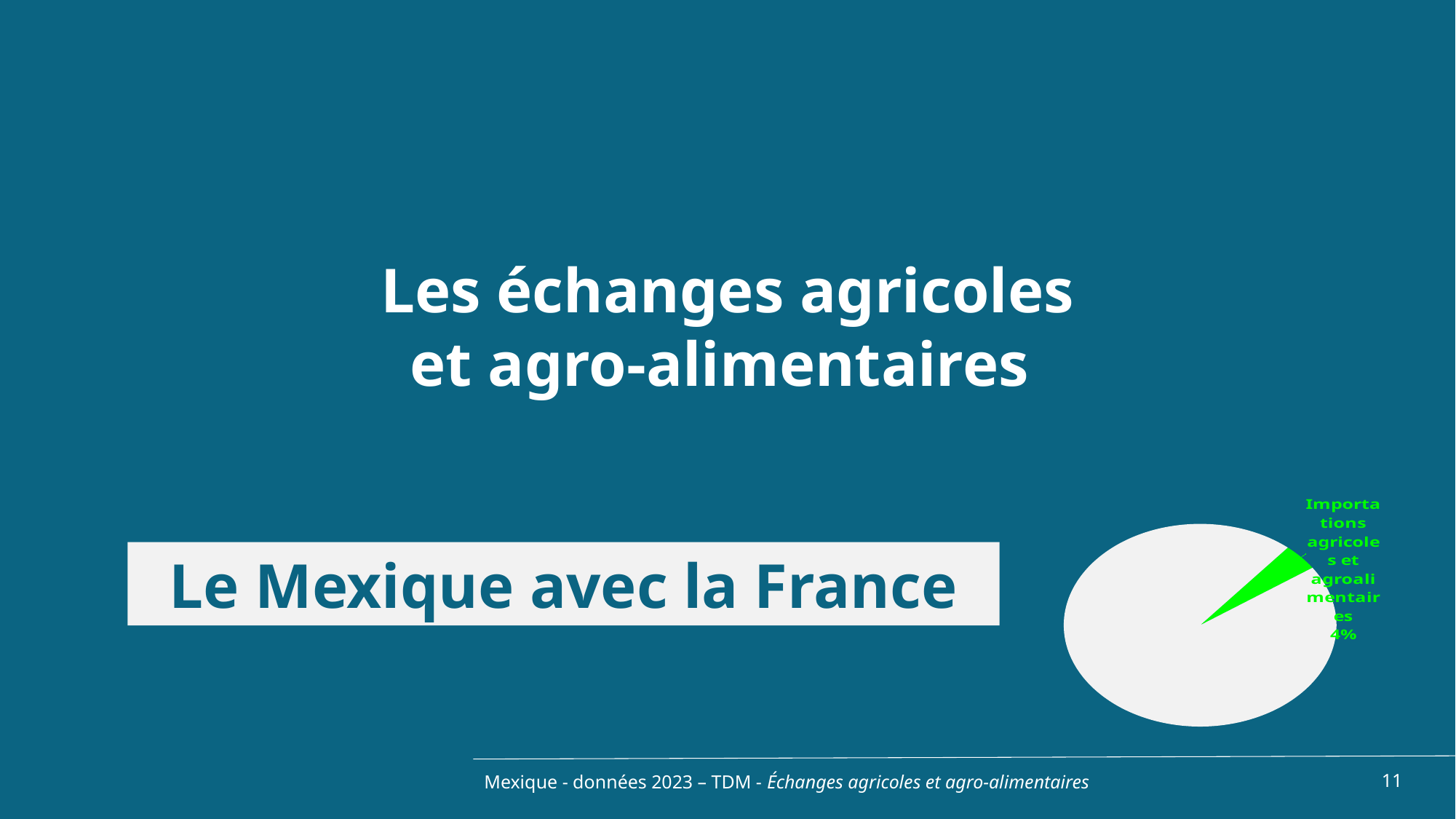
What colour is the slice labelled "Importations agricoles et agroalimentaires"? green How many slices does the pie chart show? 2 What is the percentage printed on the green slice of the pie chart? 4% Is the slice labelled "Importations agricoles et agroalimentaires" the larger or the smaller part of the pie? smaller What share of the pie does the slice labelled "Importations agricoles et agroalimentaires" represent? 4% What kind of chart is shown on the slide? pie chart